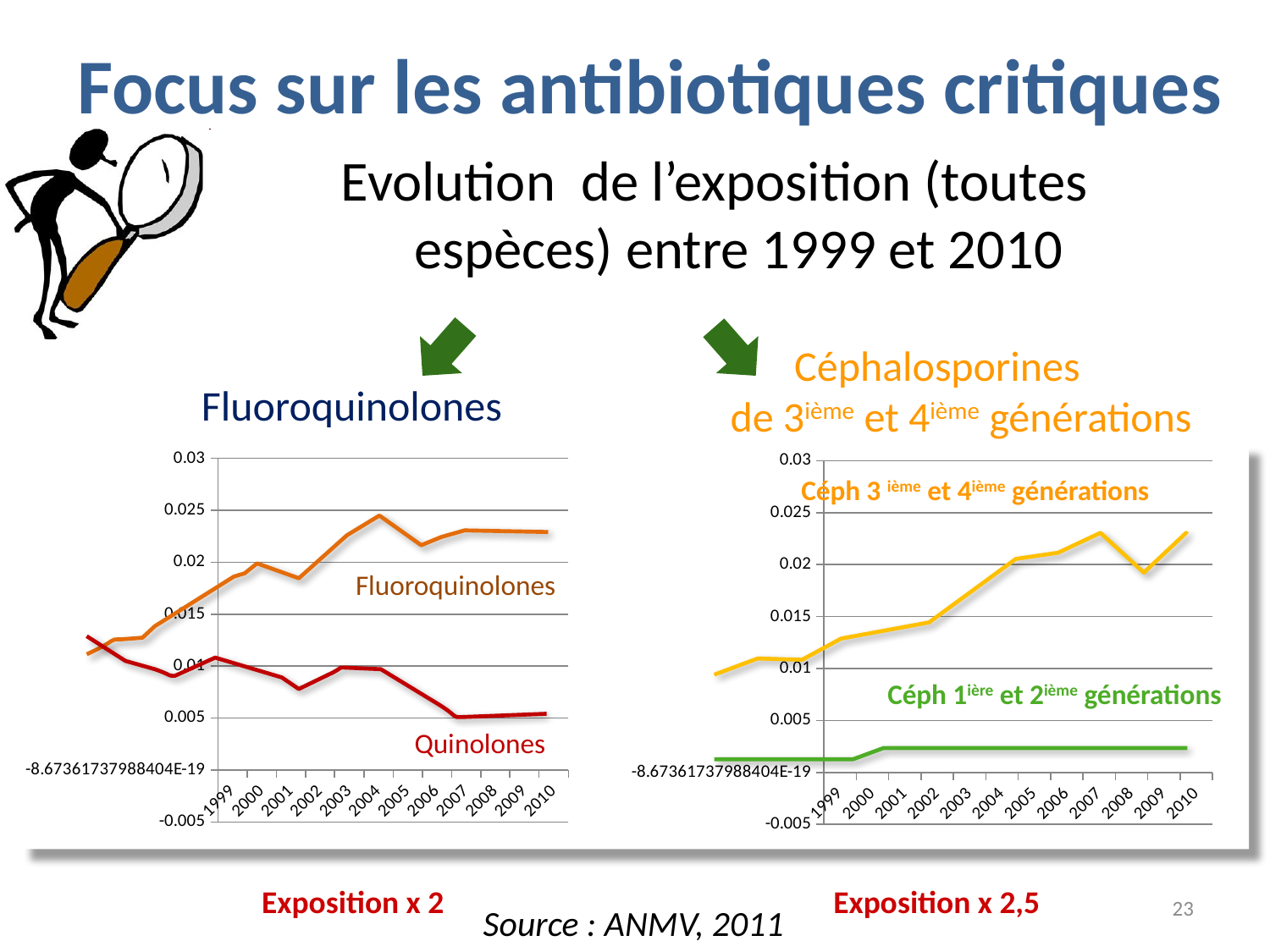
In the right chart, does the Céph 3ième et 4ième générations line rise or fall overall from 1999 to 2010? rise In the left chart, is the Fluoroquinolones value for 2004 greater or less than 0.02? greater In the left chart, is the Quinolones value for 2010 greater or less than 0.01? less How many years are plotted on the x axis of the Céphalosporines chart on the right? 12 In the left chart, which series has the larger value in 2010, Fluoroquinolones or Quinolones? Fluoroquinolones In the left chart, which year has the highest Fluoroquinolones value? 2004 In the left chart, does the Quinolones line rise or fall overall from 1999 to 2010? fall What kind of chart is the Fluoroquinolones chart on the left? line chart In the right chart, which series has the larger value in 2005, Céph 3ième et 4ième générations or Céph 1ière et 2ième générations? Céph 3ième et 4ième générations In the left chart, does the Fluoroquinolones line rise or fall overall from 1999 to 2010? rise In the right chart, is the Céph 3ième et 4ième générations value for 2010 greater or less than 0.02? greater